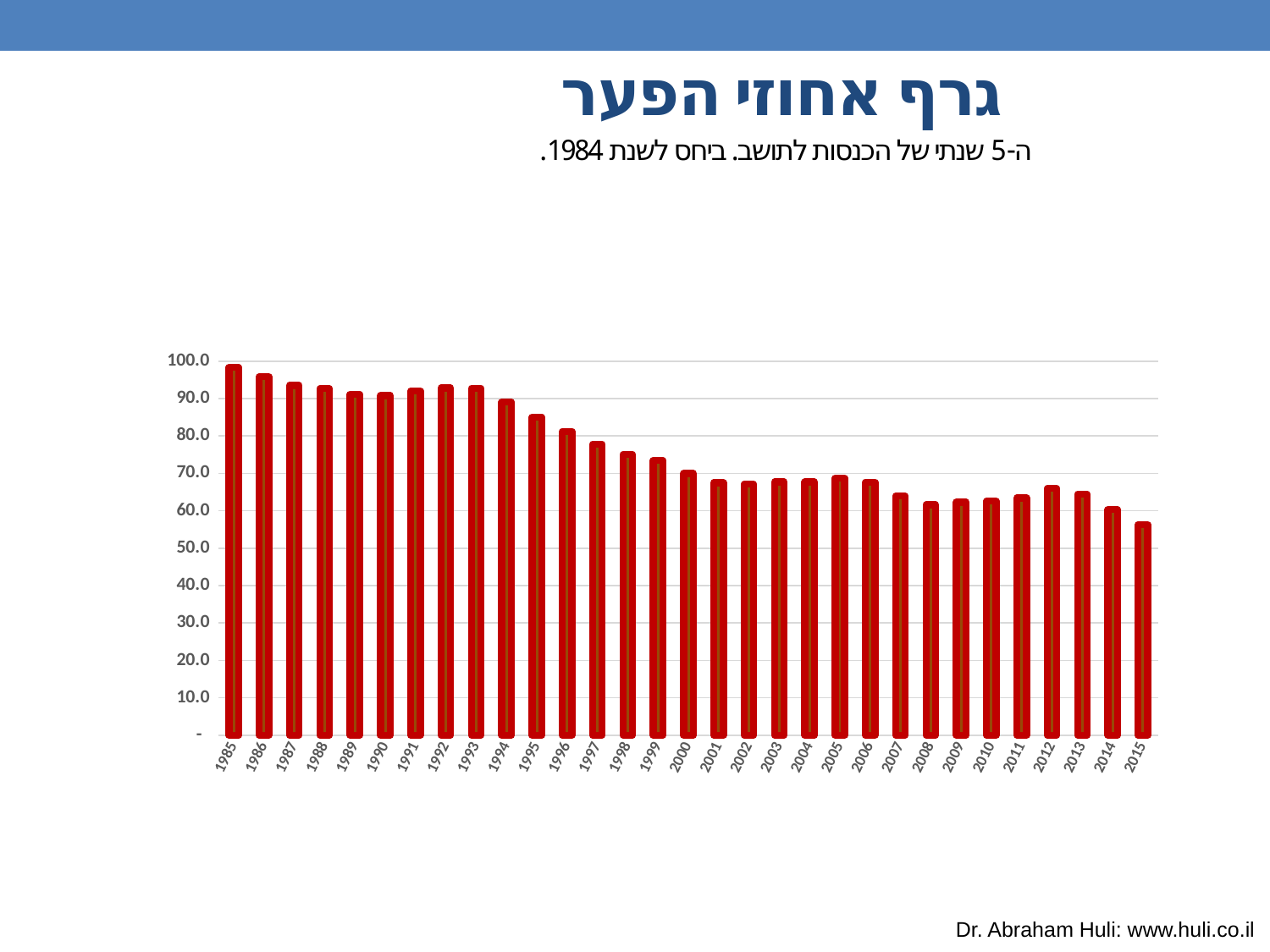
What is the title of the chart on the slide? גרף אחוזי הפער What kind of chart is shown on the slide? bar chart Which is larger, the value for 1990 or the value for 2000? 1990 Is the value for 2008 greater or less than 70? less Which year has the lowest bar? 2015 Is the value for 1998 greater or less than 80? less Is the value for 1995 greater or less than 80? greater Which year has the highest bar? 1985 How many years (bars) are plotted on the chart? 31 Do the values generally rise or fall from 1985 to 2015? fall